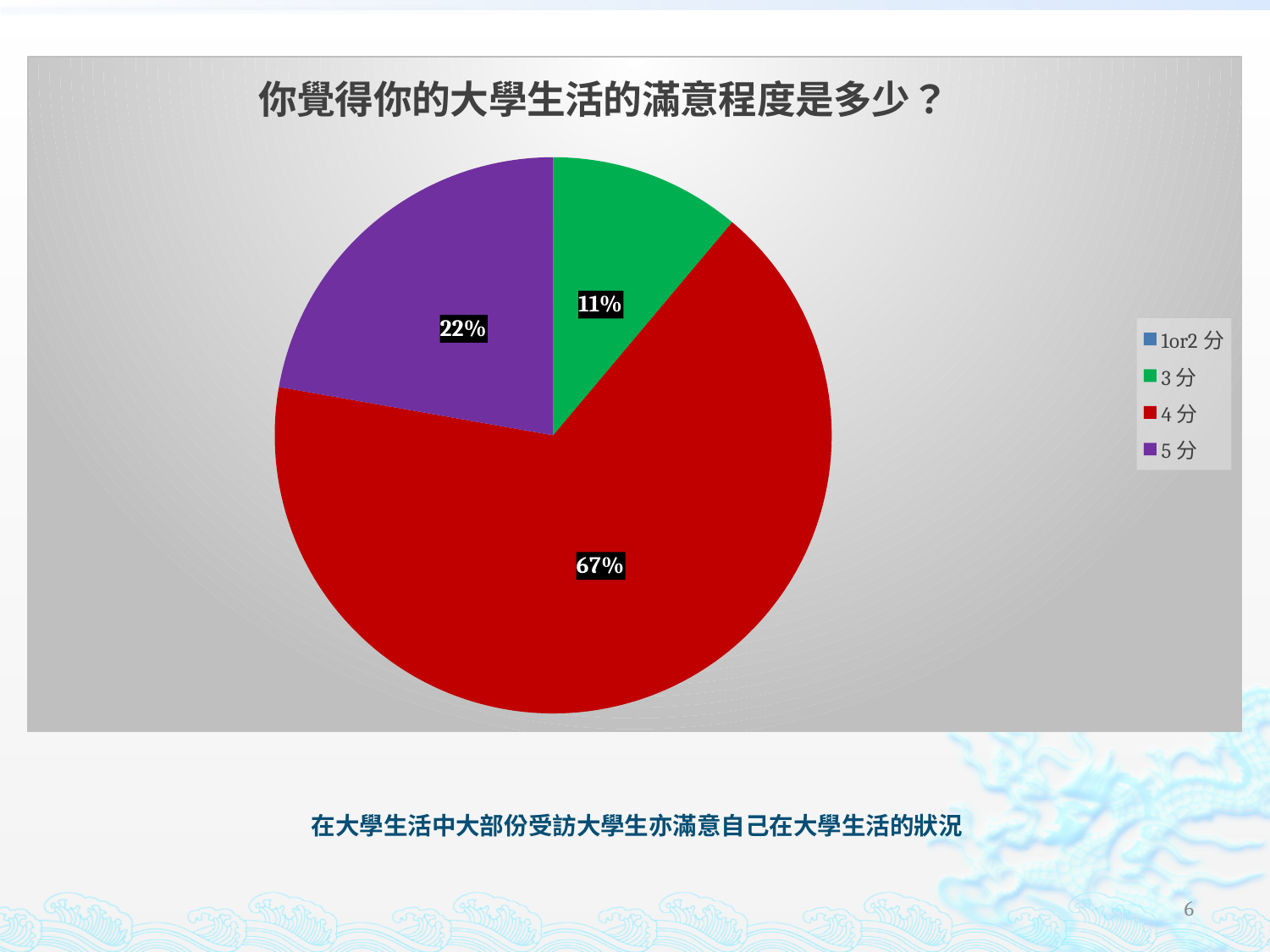
Among the slices with printed labels, which category has the smallest share? 3 分 What percentage of respondents gave a score of 4 分? 67% What is the title of the chart? 你覺得你的大學生活的滿意程度是多少？ Which is larger, the share for 5 分 or the share for 3 分? 5 分 What type of chart is shown on the slide? pie chart What is the difference between the share for 5 分 and the share for 3 分? 11% What percentage of respondents gave a score of 3 分? 11% Which category has the largest share of the pie? 4 分 What percentage of respondents gave a score of 5 分? 22% What colour is the slice for 4 分? red How many entries does the legend list? 4 What is the difference between the share for 4 分 and the share for 5 分? 45%